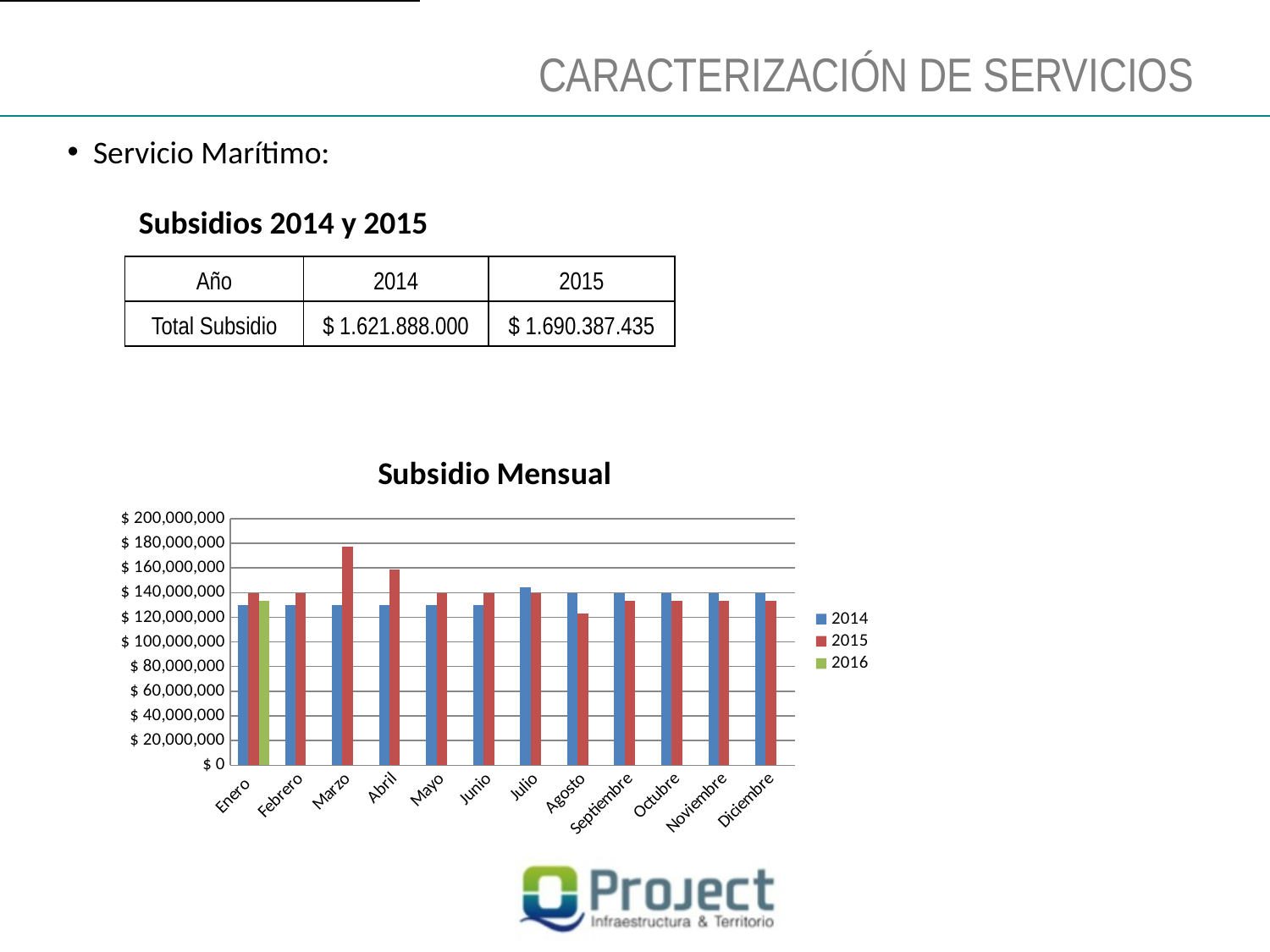
How many series does the legend of the "Subsidio Mensual" chart list? 3 What is the title of the chart on the slide? Subsidio Mensual In the "Subsidio Mensual" chart, which is larger for Marzo: the 2014 value or the 2015 value? 2015 In the "Subsidio Mensual" chart, which month has the highest value for the 2015 series? Marzo In the "Subsidio Mensual" chart, is the 2015 value for Agosto greater or less than $ 140,000,000? less In the "Subsidio Mensual" chart, is the 2014 value for Enero greater or less than $ 100,000,000? greater How many months are shown on the x axis of the "Subsidio Mensual" chart? 12 In the "Subsidio Mensual" chart, which month has the lowest value for the 2015 series? Agosto In the "Subsidio Mensual" chart, which is larger for Agosto: the 2014 value or the 2015 value? 2014 What kind of chart is the "Subsidio Mensual" chart? bar chart In the "Subsidio Mensual" chart, which month is the only one with a bar for the 2016 series? Enero In the "Subsidio Mensual" chart, is the 2015 value for Marzo greater or less than $ 160,000,000? greater